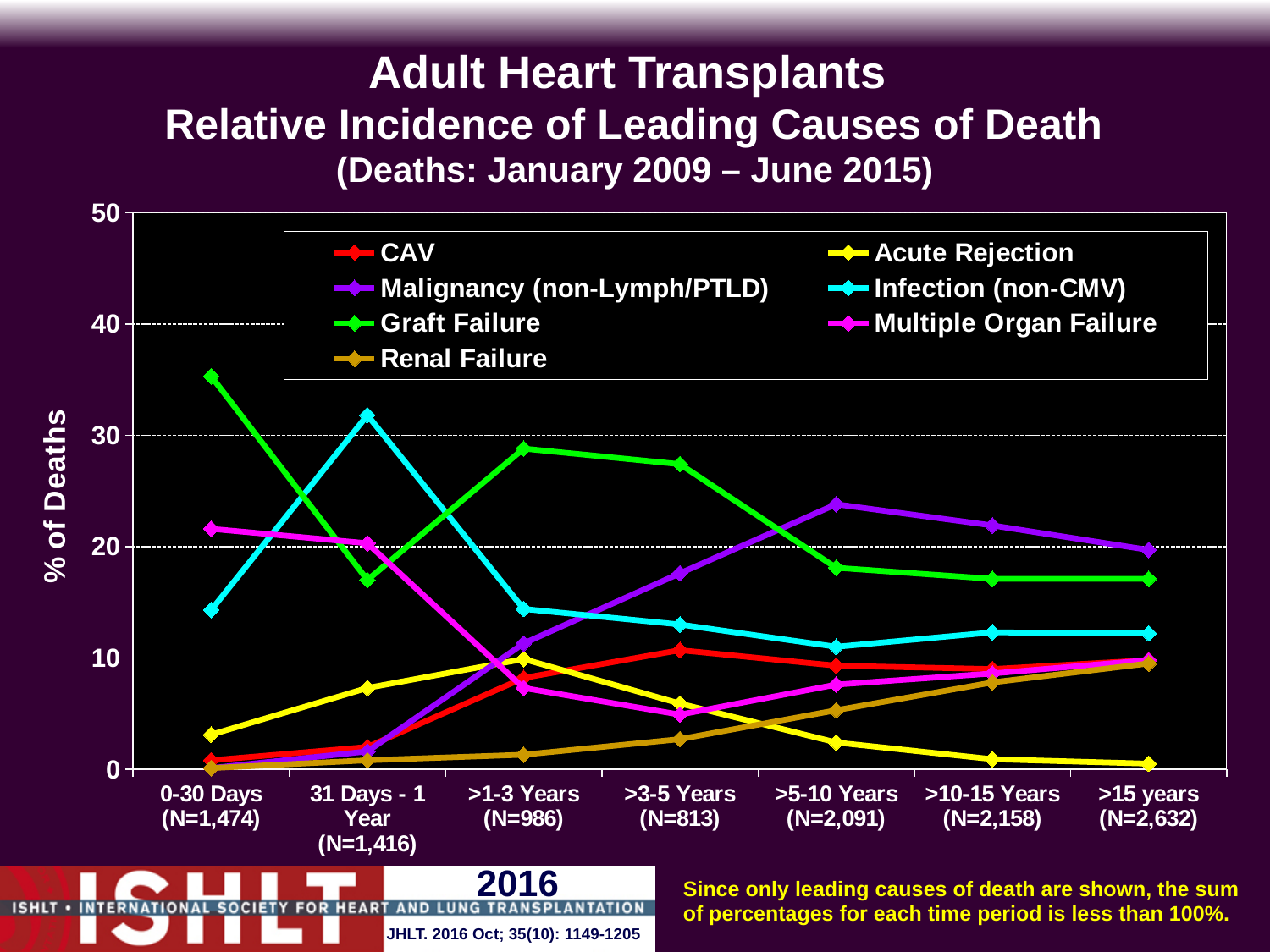
Which cause of death has the highest percentage in the 31 Days - 1 Year period? Infection (non-CMV) In the >15 years period, which is larger: Malignancy (non-Lymph/PTLD) or Graft Failure? Malignancy (non-Lymph/PTLD) How many series does the legend list? 7 Does the Renal Failure line rise or fall from 0-30 Days to >15 years? Rises Which cause of death has the highest percentage in the >5-10 Years period? Malignancy (non-Lymph/PTLD) How many time-period categories are shown on the x axis? 7 Which cause of death has the lowest percentage in the >15 years period? Acute Rejection What is the label on the y axis? % of Deaths What kind of chart is shown on the slide? Line chart Which cause of death has the highest percentage in the 0-30 Days period? Graft Failure Is the value for Graft Failure in the 0-30 Days period greater or less than 30? greater Is the value for Malignancy (non-Lymph/PTLD) in the >5-10 Years period greater or less than 20? greater